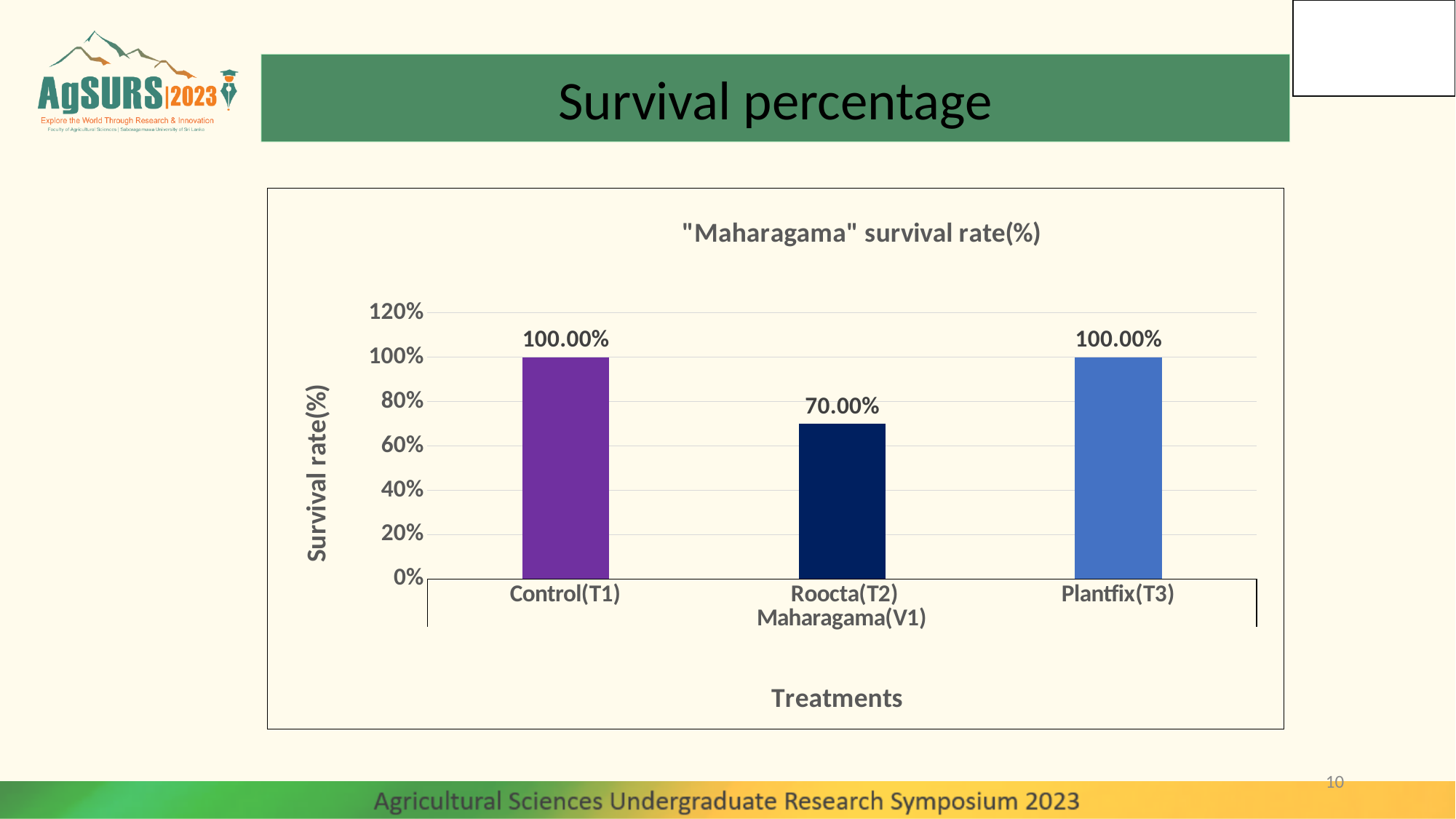
Which has a higher survival rate, Plantfix(T3) or Roocta(T2)? Plantfix(T3) What is the survival rate for Control(T1)? 100.00% How many treatments are shown on the chart? 3 Is the survival rate for Roocta(T2) greater or less than 80%? less What is the survival rate for Roocta(T2)? 70.00% What is the label of the y axis? Survival rate(%) What is the label of the x axis? Treatments What is the survival rate for Plantfix(T3)? 100.00% What is the difference in survival rate between Control(T1) and Roocta(T2)? 30.00% What is the title of the chart? "Maharagama" survival rate(%) Which treatment has the lowest survival rate? Roocta(T2) What kind of chart is shown on the slide? Bar chart